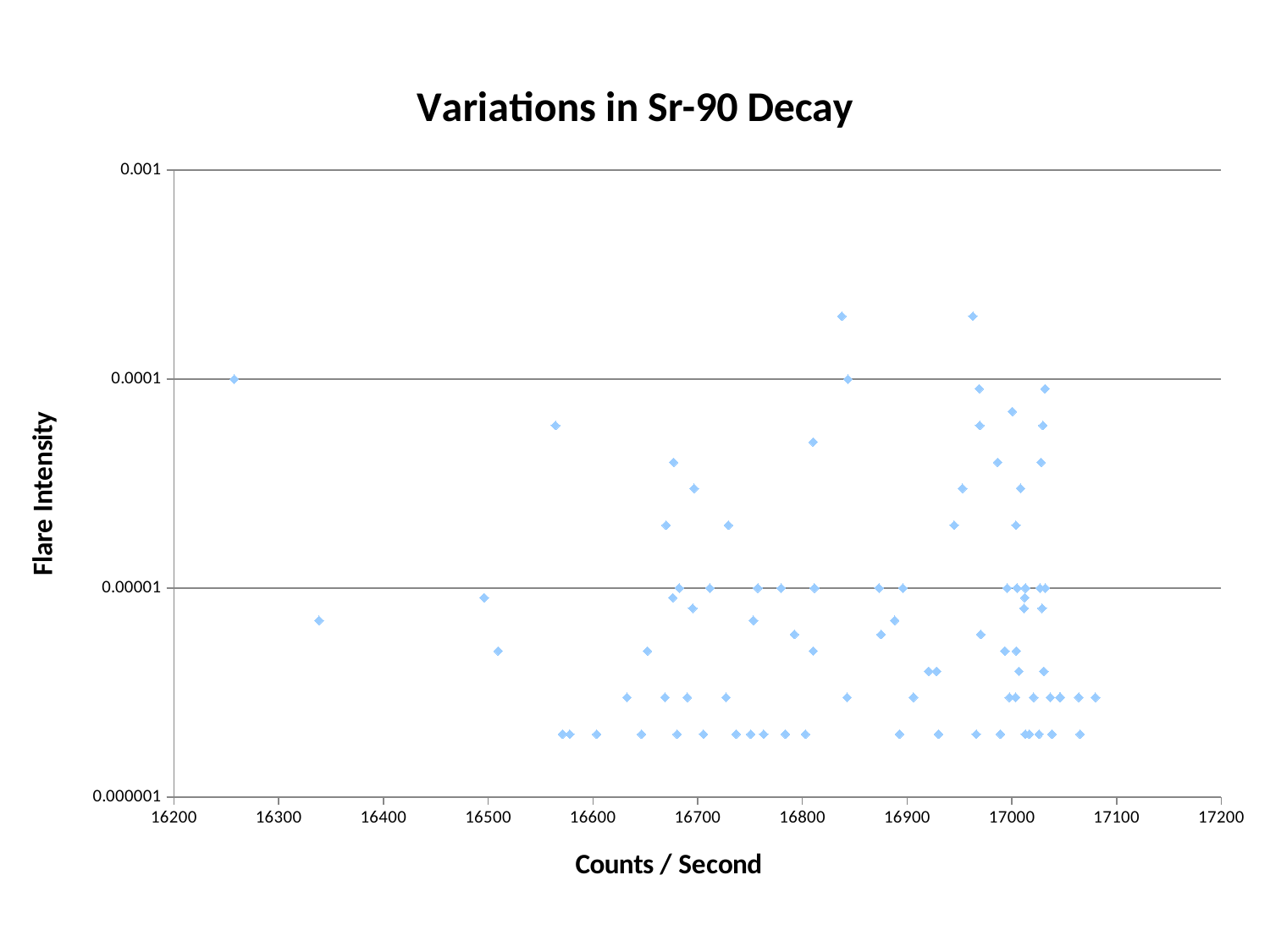
Is the flare intensity of the leftmost point (near 16260 counts/second) greater or less than 0.00001? greater Is the flare intensity of the point near 16560 counts/second greater or less than 0.00001? greater What is the label on the x axis of the chart? Counts / Second Is the flare intensity of the point near 16340 counts/second greater or less than 0.00001? less What kind of chart is shown on the slide? Scatter chart Which has the higher flare intensity: the point near 16260 counts/second or the point near 16340 counts/second? The point near 16260 What is the title of the chart? Variations in Sr-90 Decay